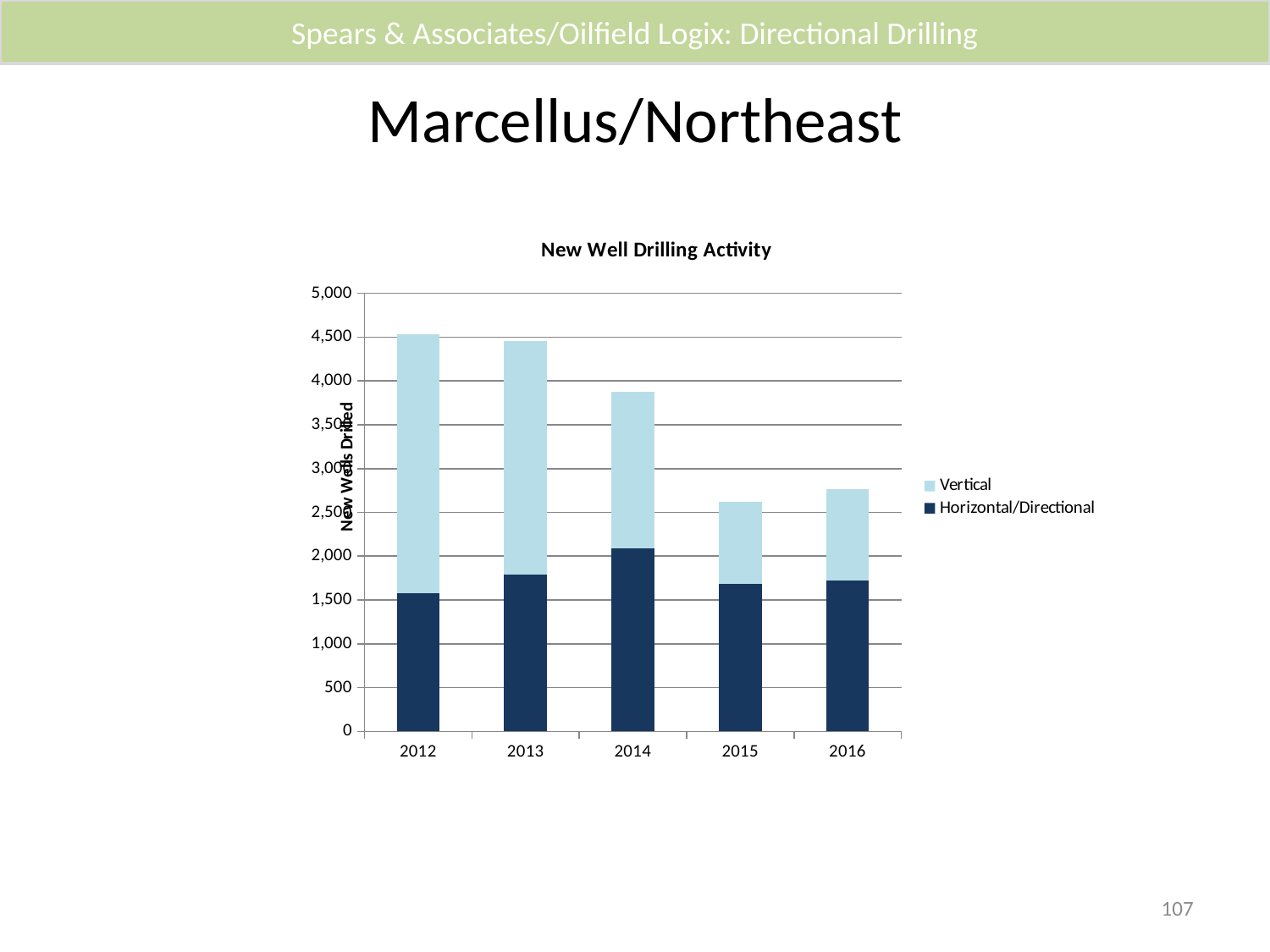
In which year is the Horizontal/Directional value highest? 2014 What is the title of the chart? New Well Drilling Activity What kind of chart is shown on the slide? Bar chart Is the total height of the 2012 bar greater or less than 4,000? greater How many series does the chart's legend list? 2 Do the total bar heights generally rise or fall from 2012 to 2016? fall Which series is shown in the darker blue colour? Horizontal/Directional Is the total height of the 2014 bar greater or less than 4,000? less Which year has the larger total bar, 2013 or 2014? 2013 In which year is the Horizontal/Directional value lowest? 2012 How many years are shown on the x axis of the chart? 5 Is the total height of the 2016 bar greater or less than 3,000? less